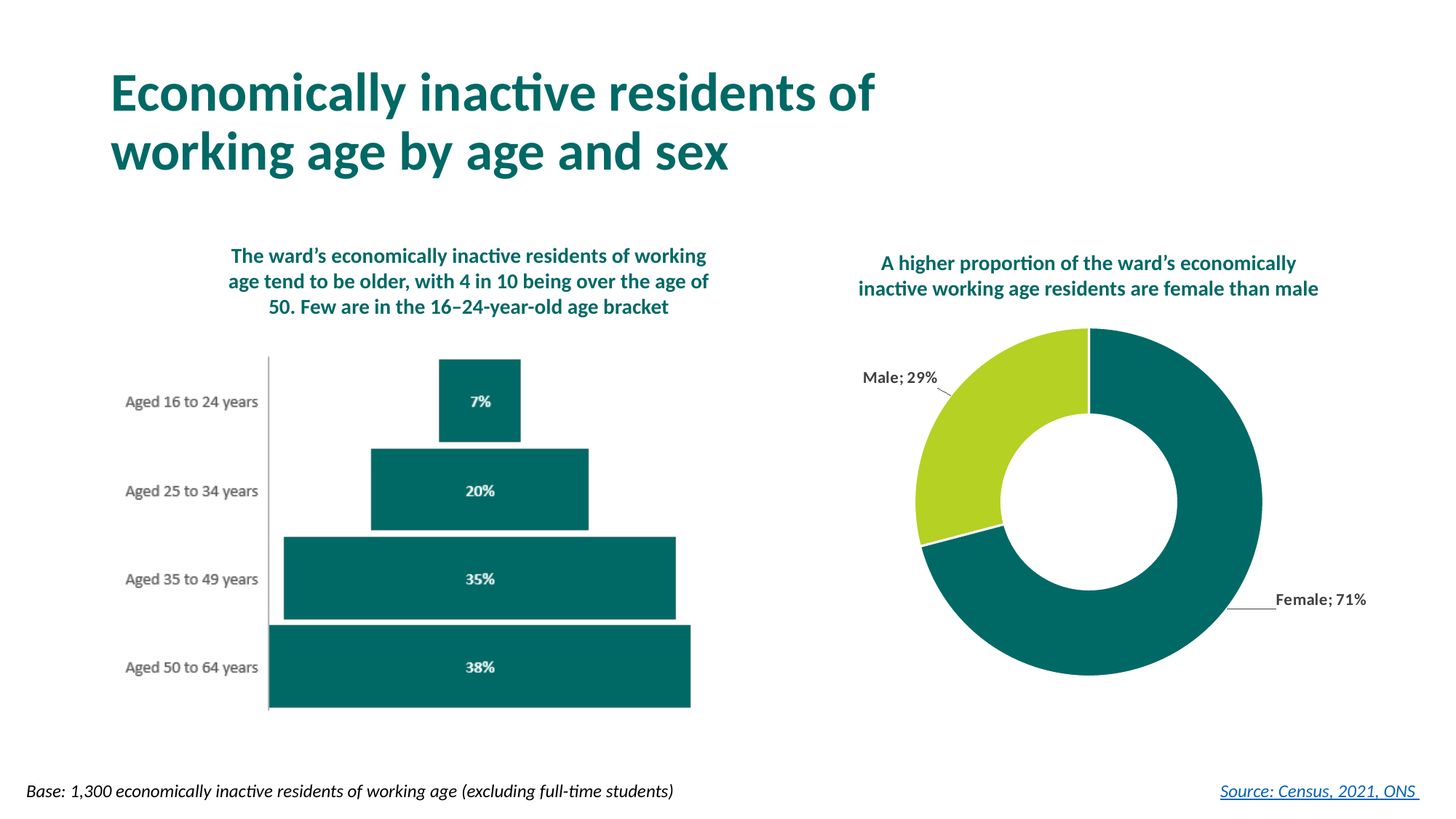
What kind of chart is the left-hand chart showing economically inactive residents by age? Bar chart In the left-hand bar chart of economically inactive residents by age, which age group has the highest value? Aged 50 to 64 years In the left-hand bar chart of economically inactive residents by age, which age group has the lowest value? Aged 16 to 24 years In the right-hand doughnut chart of economically inactive residents by sex, what is the value for Male? 29% In the left-hand bar chart of economically inactive residents by age, which is larger: the value for Aged 25 to 34 years or Aged 35 to 49 years? Aged 35 to 49 years In the left-hand bar chart of economically inactive residents by age, what is the difference between the values for Aged 50 to 64 years and Aged 25 to 34 years? 18 percentage points In the right-hand doughnut chart of economically inactive residents by sex, what is the difference between the Female and Male shares? 42 percentage points How many age categories are shown in the left-hand bar chart? 4 In the right-hand doughnut chart of economically inactive residents by sex, what is the value for Female? 71% In the left-hand bar chart of economically inactive residents by age, what is the value for Aged 35 to 49 years? 35% In the left-hand bar chart of economically inactive residents by age, what is the value for Aged 16 to 24 years? 7% What kind of chart is the right-hand chart showing economically inactive residents by sex? Doughnut chart